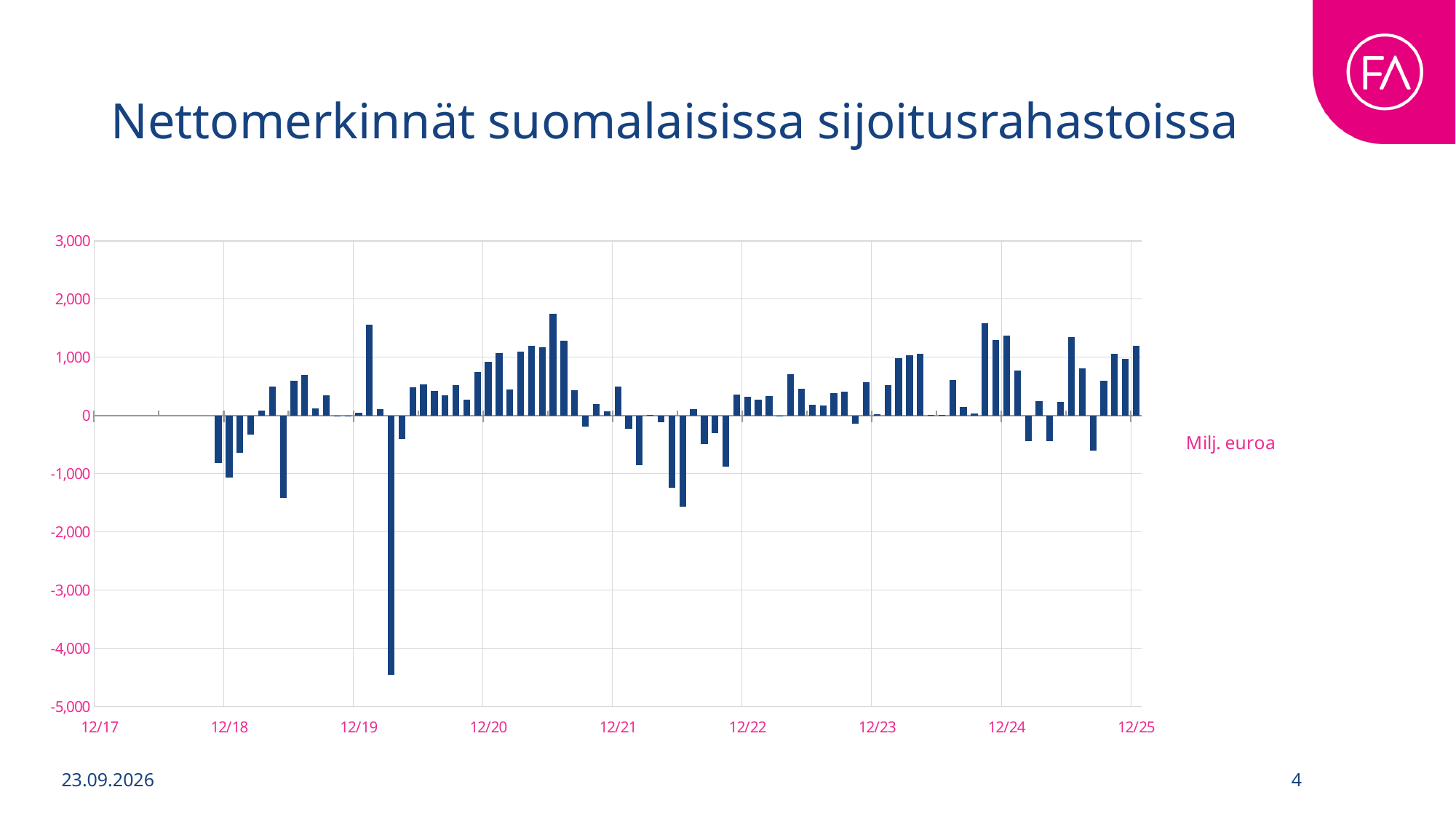
Is the value of the highest bar in the chart greater or less than 1,000? greater What kind of chart is shown on the slide? Bar chart Between which two x-axis labels does the lowest bar in the chart fall? Between 12/19 and 12/20 What is the highest value shown on the y axis? 3,000 How many labels are shown on the x axis of the chart? 9 Is the value of the lowest bar in the chart greater or less than -4,000? less Are the bars between 12/24 and 12/25 mostly positive or mostly negative? Mostly positive What is the lowest value shown on the y axis? -5,000 What is the title of the chart? Nettomerkinnät suomalaisissa sijoitusrahastoissa Is the value of the highest bar in the chart greater or less than 2,000? less Which x-axis label is the first one shown on the chart? 12/17 What unit is indicated next to the chart? Milj. euroa